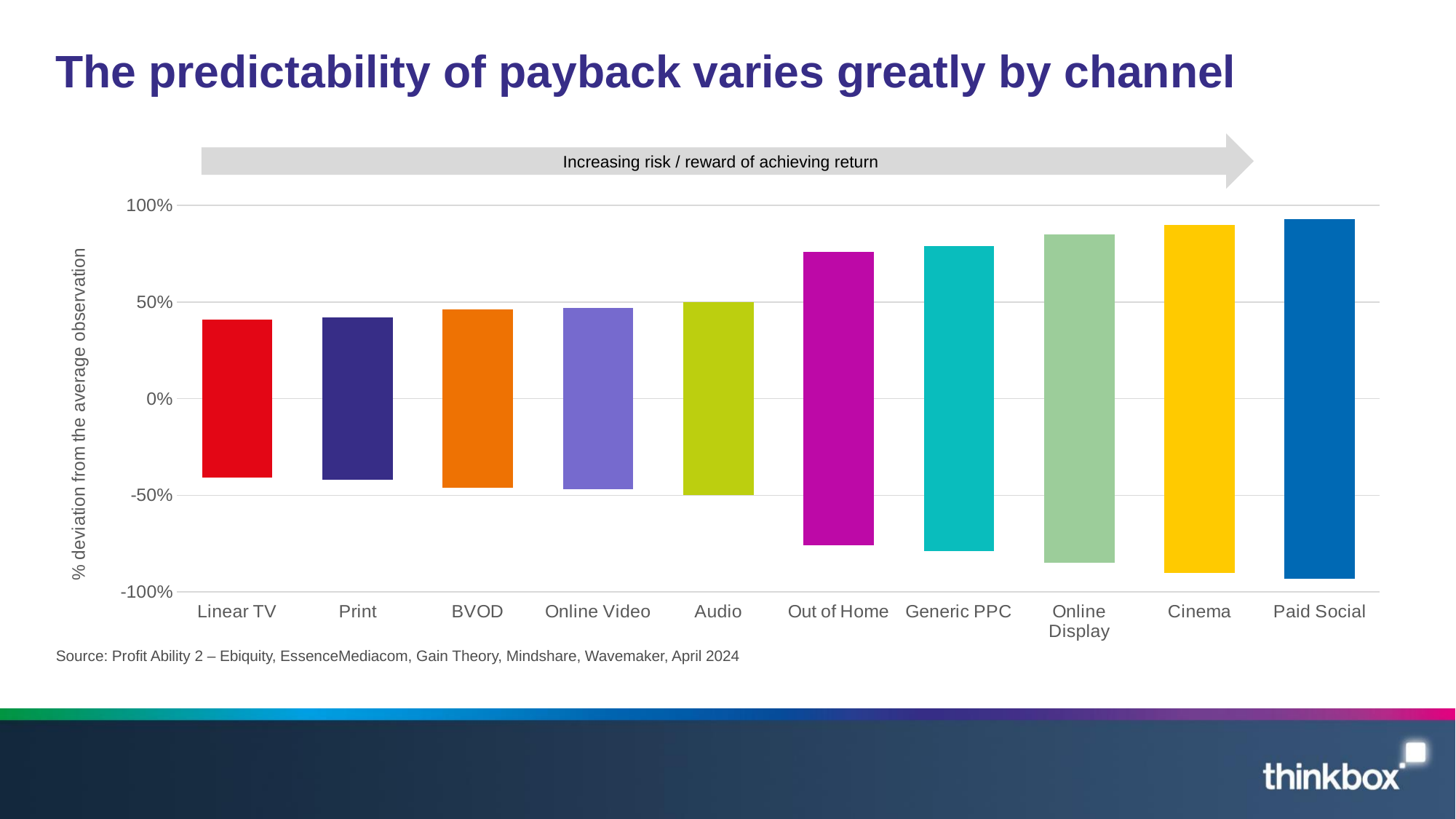
Which channel has a wider range of deviation, Cinema or Print? Cinema What is the title of the chart on the slide? The predictability of payback varies greatly by channel Which channel has the widest range of % deviation from the average observation? Paid Social Is the upper end of the bar for Paid Social greater or less than 50%? greater Is the upper end of the bar for Linear TV greater or less than 50%? less What kind of chart is shown on the slide? bar chart How many channels are shown on the x axis of the chart? 10 Do the ranges of deviation widen or narrow moving from left to right along the x axis? widen What does the arrow above the chart say? Increasing risk / reward of achieving return Which channel has the narrowest range of % deviation from the average observation? Linear TV Is the upper end of the bar for Print greater or less than 50%? less